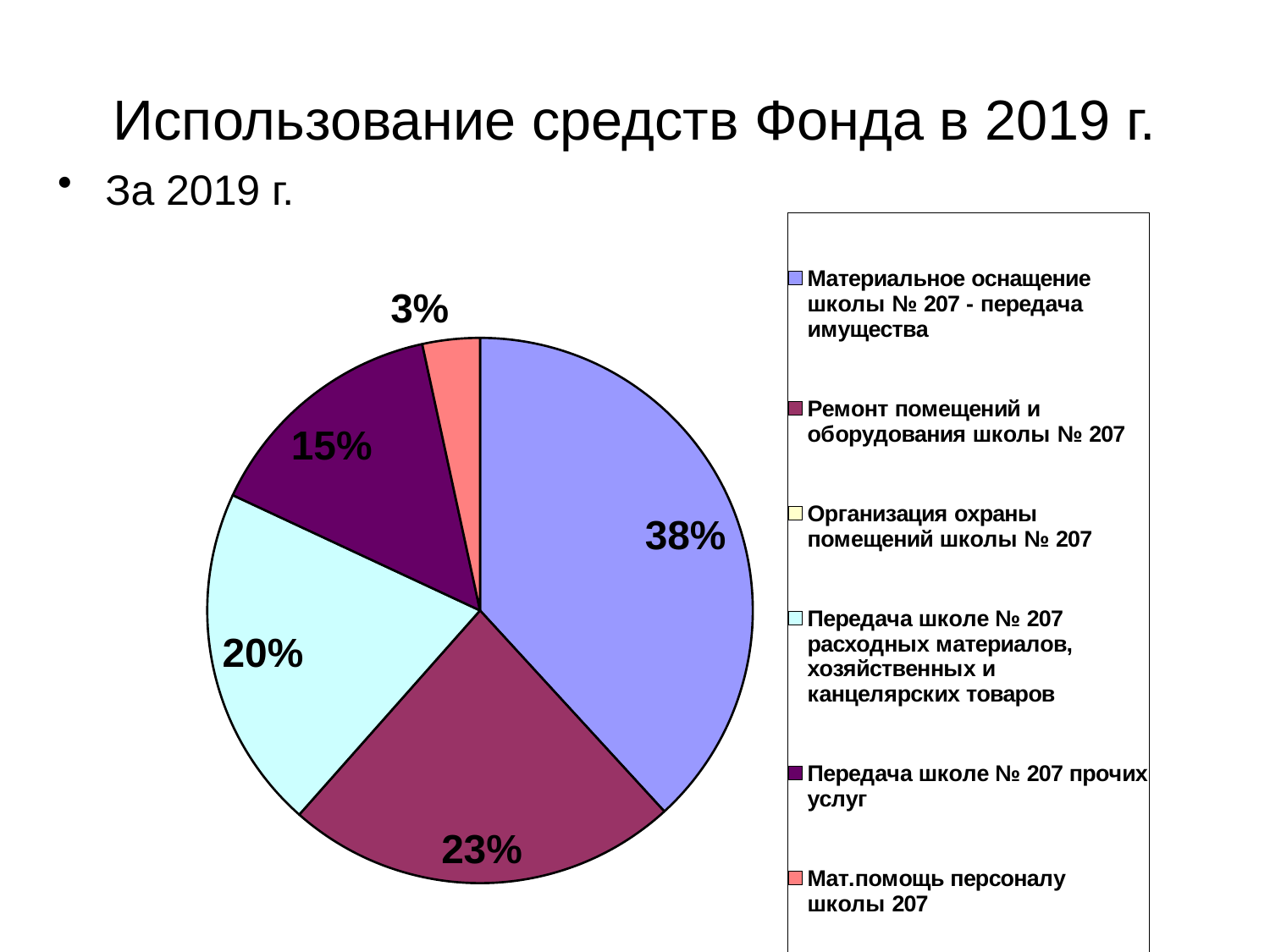
What share of the fund's spending went to "Мат.помощь персоналу школы 207"? 3% Which labelled slice has the smallest share of the pie? Мат.помощь персоналу школы 207 How many categories does the legend list? 6 What share of the fund's spending went to "Передача школе № 207 расходных материалов, хозяйственных и канцелярских товаров"? 20% What kind of chart is shown on the slide? pie chart Which category has the largest share of the pie? Материальное оснащение школы № 207 - передача имущества What is the title of the slide containing the pie chart? Использование средств Фонда в 2019 г. What share of the fund's spending went to "Передача школе № 207 прочих услуг"? 15% What share of the fund's spending went to "Материальное оснащение школы № 207 - передача имущества"? 38% Which is larger: the share for "Передача школе № 207 расходных материалов, хозяйственных и канцелярских товаров" or the share for "Передача школе № 207 прочих услуг"? Передача школе № 207 расходных материалов, хозяйственных и канцелярских товаров What is the difference in percentage points between the share for "Материальное оснащение школы № 207 - передача имущества" and the share for "Ремонт помещений и оборудования школы № 207"? 15 percentage points What share of the fund's spending went to "Ремонт помещений и оборудования школы № 207"? 23%